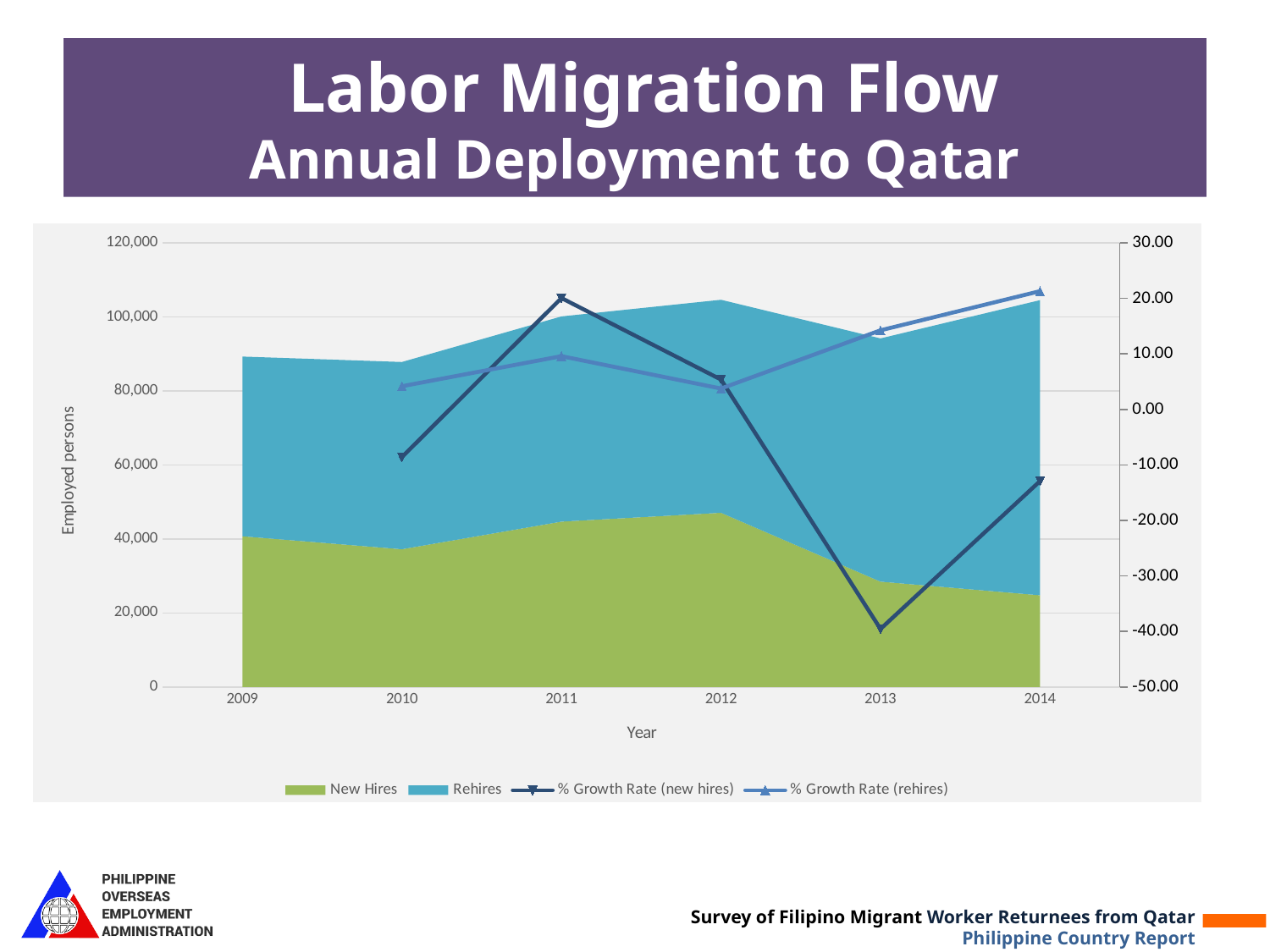
In which year is the % Growth Rate (rehires) highest? 2014 Is the value for New Hires in 2014 greater or less than 30,000? less How many series does the chart legend list? 4 Do the New Hires values rise or fall from 2012 to 2014? fall Is the % Growth Rate (new hires) in 2013 greater or less than -30.00? less How many years are shown on the x axis of the chart? 6 In 2011, which is larger: the % Growth Rate (new hires) or the % Growth Rate (rehires)? % Growth Rate (new hires) In which year is the % Growth Rate (new hires) lowest? 2013 Is the % Growth Rate (new hires) in 2011 greater or less than 10.00? greater What is the title of the vertical axis on the left of the chart? Employed persons What kind of chart is shown on the slide? A combined area and line chart